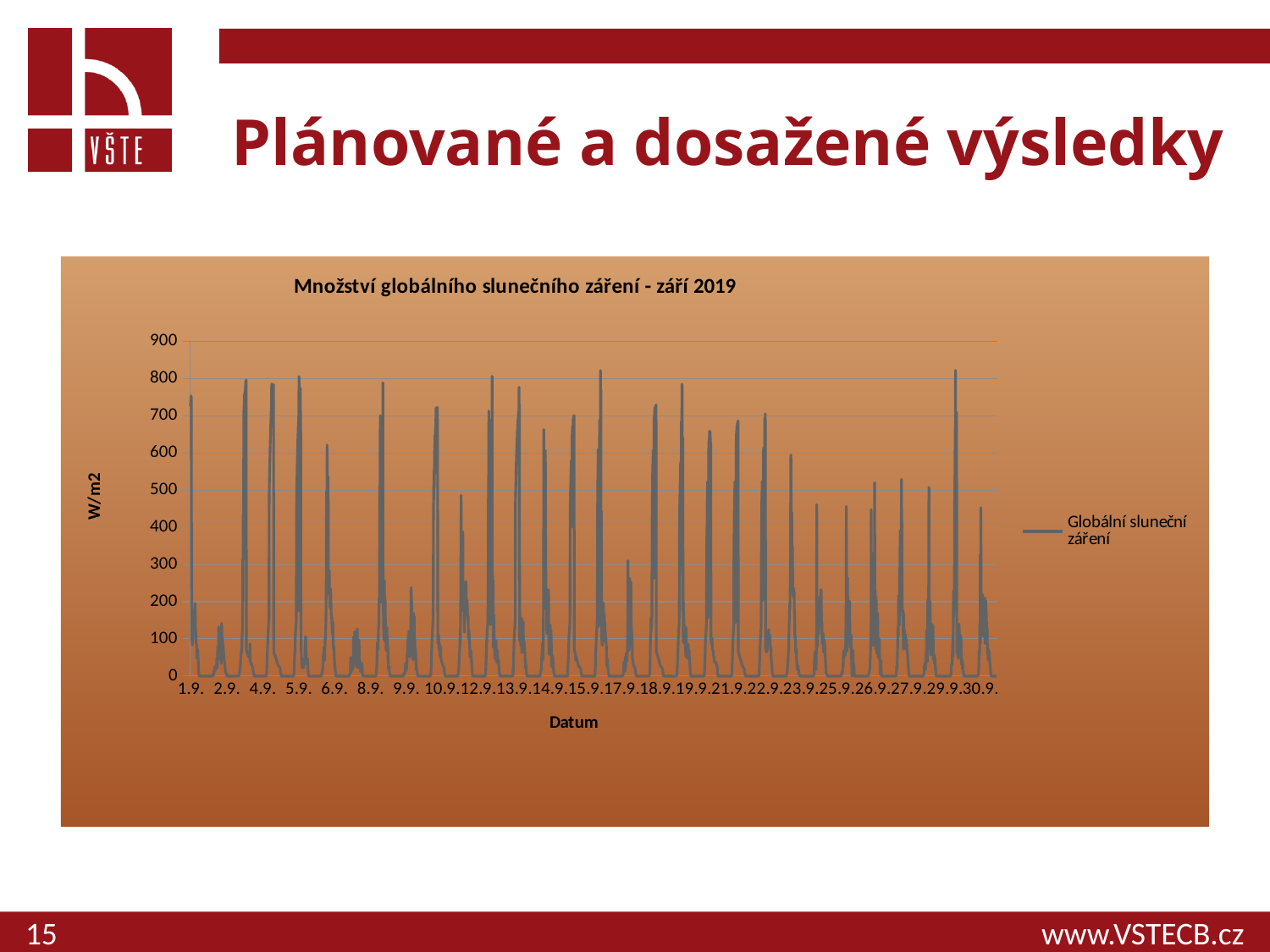
How many series does the chart's legend list? 1 Which day has the higher peak value, 4.9. or 25.9.? 4.9. Are the daily peak values in the last week of September generally higher or lower than those in the first week? lower What is the title of the chart? Množství globálního slunečního záření - září 2019 Is the peak value on 23.9. greater or less than 500? greater What is the name of the series shown in the legend? Globální sluneční záření What is the highest value shown on the vertical axis? 900 Is the peak value on 12.9. greater or less than 600? greater What kind of chart is shown on the slide? line chart Is the peak value on 1.9. greater or less than 700? greater